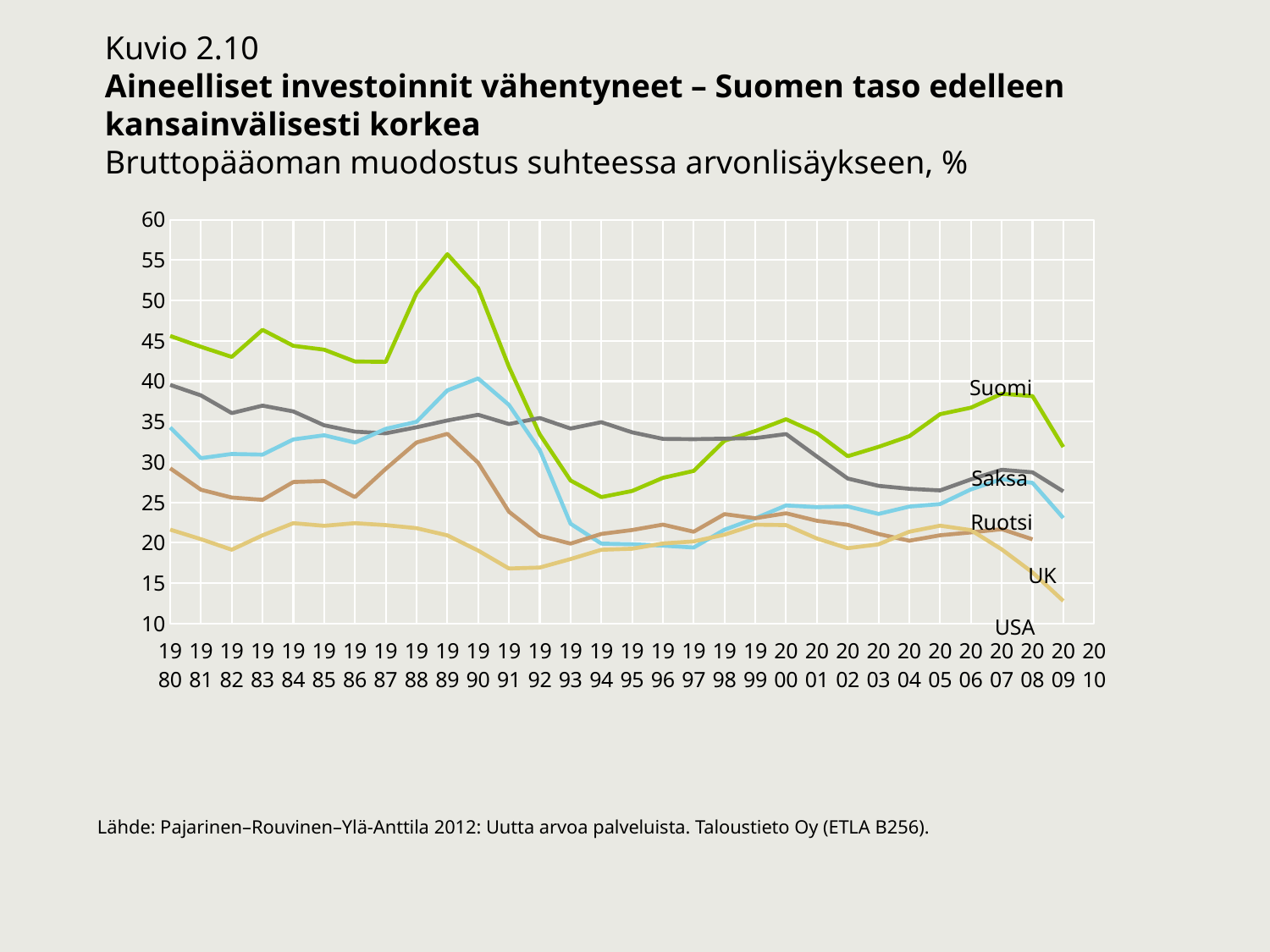
How many country series are plotted on the chart? 5 Is the value for Suomi in 1994 greater or less than 30? less What kind of chart is shown on the slide? line chart Which is larger in 1990, the value for Ruotsi or the value for UK? Ruotsi Does the value for Suomi rise or fall between 1989 and 1994? fall Which country has the lowest value in 2009? USA What is the subtitle describing the measure plotted on the chart? Bruttopääoman muodostus suhteessa arvonlisäykseen, % Is the value for USA in 2009 greater or less than 15? less Which country has the lowest value in 1991? USA Is the value for Suomi in 1989 greater or less than 50? greater Which country has the highest value in 1989? Suomi